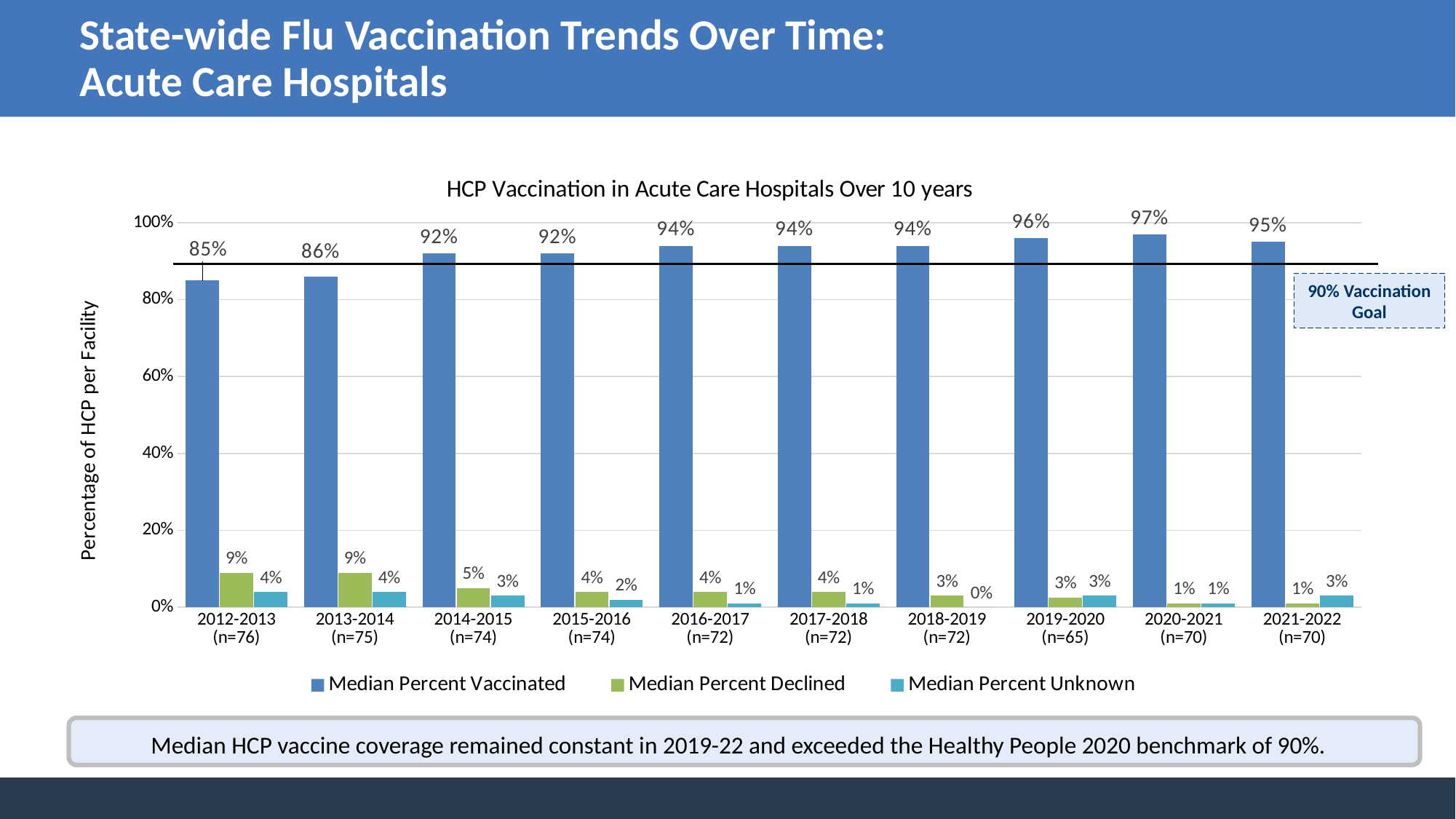
What is the Median Percent Vaccinated for 2012-2013 (n=76)? 85% What is the difference in Median Percent Vaccinated between 2020-2021 and 2012-2013? 12% What is the Median Percent Declined for 2014-2015 (n=74)? 5% What is the Median Percent Unknown for 2021-2022 (n=70)? 3% Which season has the lowest Median Percent Vaccinated? 2012-2013 (n=76) What is the title of the chart? HCP Vaccination in Acute Care Hospitals Over 10 years What kind of chart is shown? bar chart Which is larger, the Median Percent Declined for 2013-2014 or for 2019-2020? 2013-2014 Which season has the highest Median Percent Vaccinated? 2020-2021 (n=70) Is the Median Percent Vaccinated for 2013-2014 greater or less than 90%? less How many seasons are shown on the x axis? 10 How many series does the legend list? 3